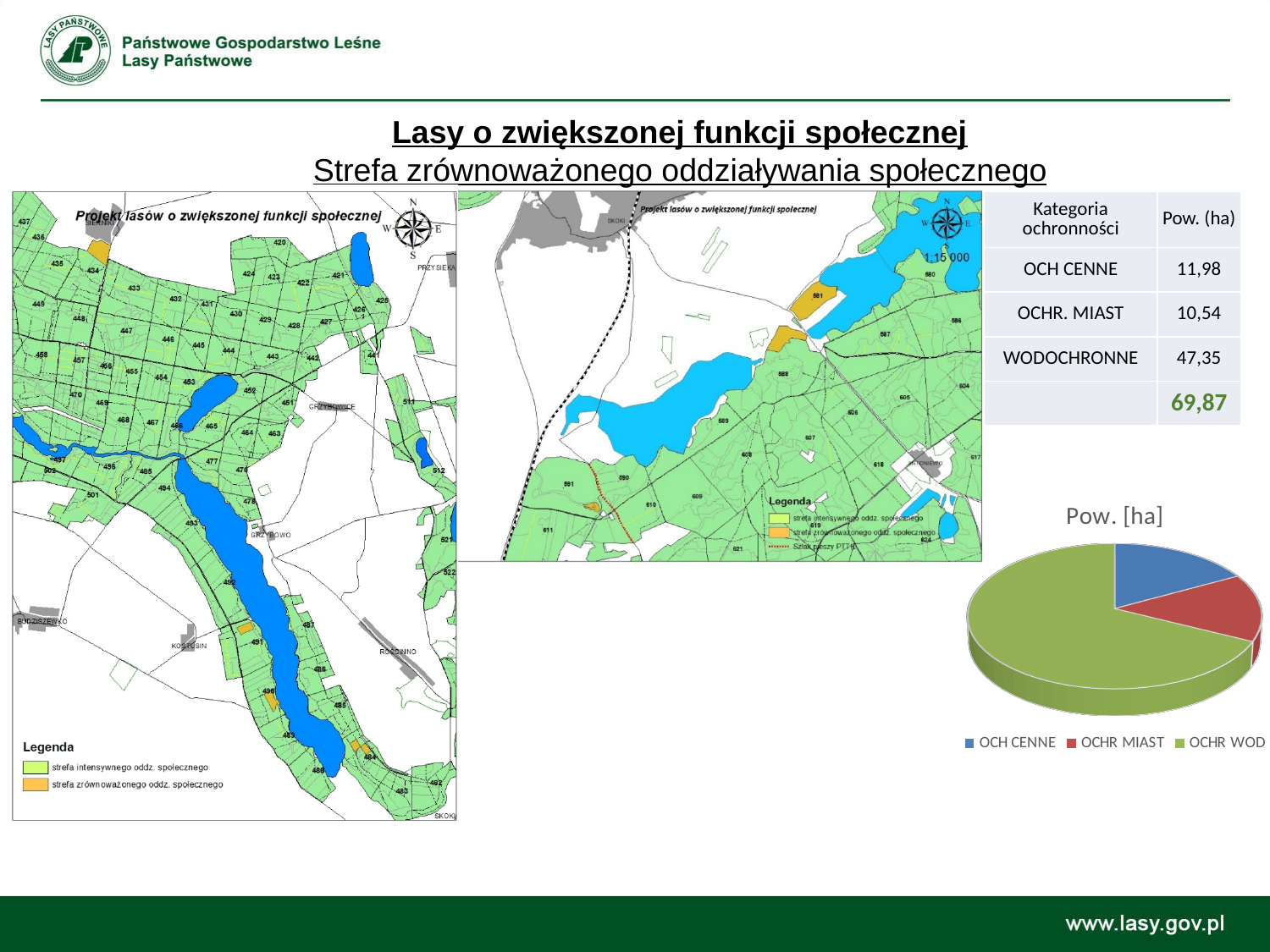
How many slices does the pie chart have? 3 Which category has the largest slice in the pie chart? OCHR WOD What is the title of the pie chart on the slide? Pow. [ha] In the pie chart, which slice is larger: OCH CENNE or OCHR WOD? OCHR WOD What colour is the OCH CENNE slice in the pie chart? blue In the pie chart, which slice is larger: OCHR MIAST or OCHR WOD? OCHR WOD What kind of chart is shown at the bottom right of the slide? pie chart Does the OCHR WOD slice make up more or less than half of the pie chart? more How many entries does the legend of the pie chart list? 3